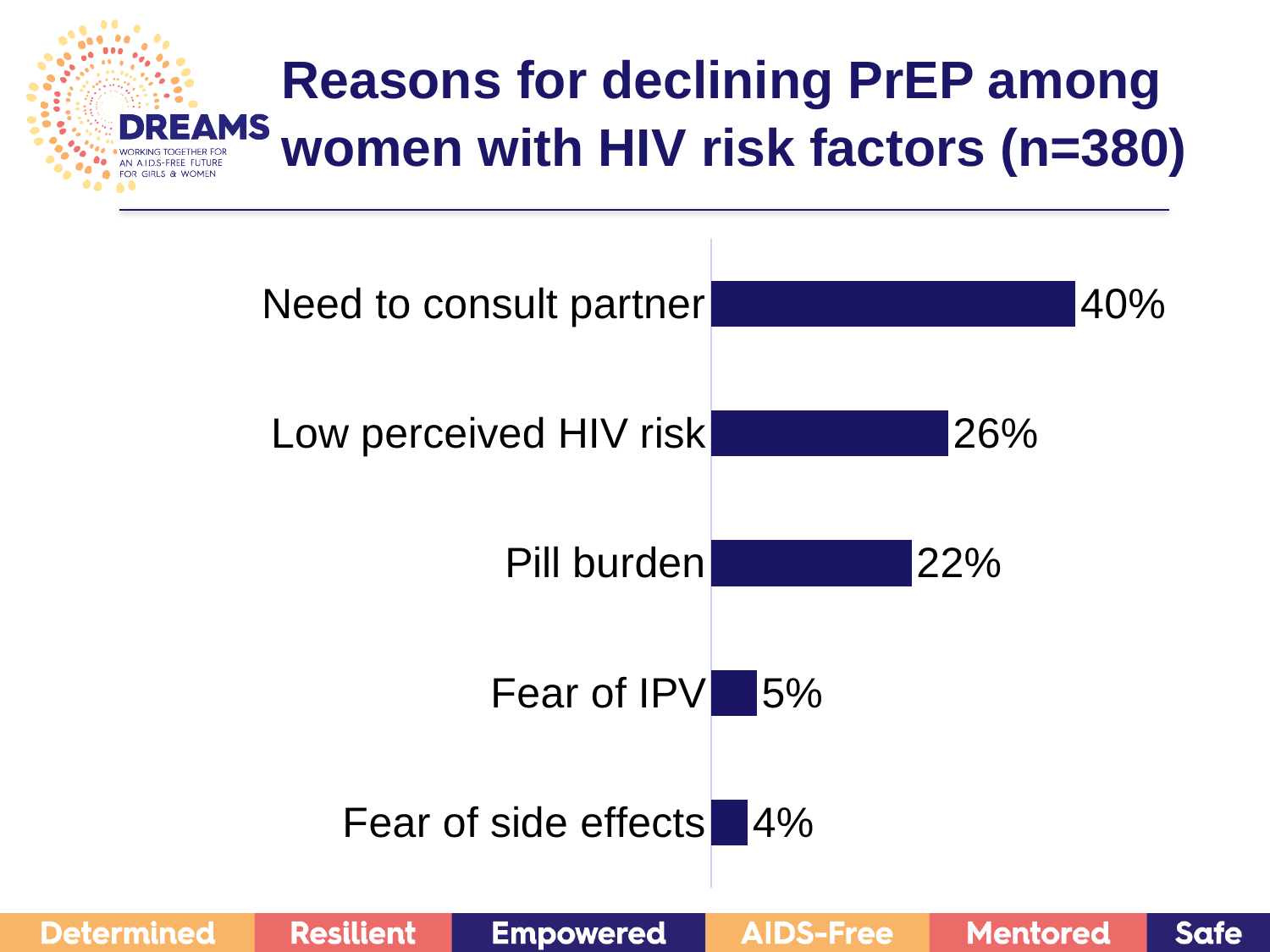
What is the difference in percentage points between 'Pill burden' and 'Fear of side effects'? 18 What is the value shown for 'Low perceived HIV risk'? 26% Which is larger: the value for 'Low perceived HIV risk' or the value for 'Pill burden'? Low perceived HIV risk What is the value shown for 'Fear of IPV'? 5% What percentage of women cited 'Need to consult partner' as a reason for declining PrEP? 40% How many reasons for declining PrEP are shown in the chart? 5 What is the value shown for 'Pill burden'? 22% Which reason for declining PrEP has the lowest value? Fear of side effects What is the sample size (n) stated in the chart title? 380 What is the difference in percentage points between 'Need to consult partner' and 'Low perceived HIV risk'? 14 Which reason for declining PrEP has the highest value? Need to consult partner What kind of chart is shown on the slide? Bar chart